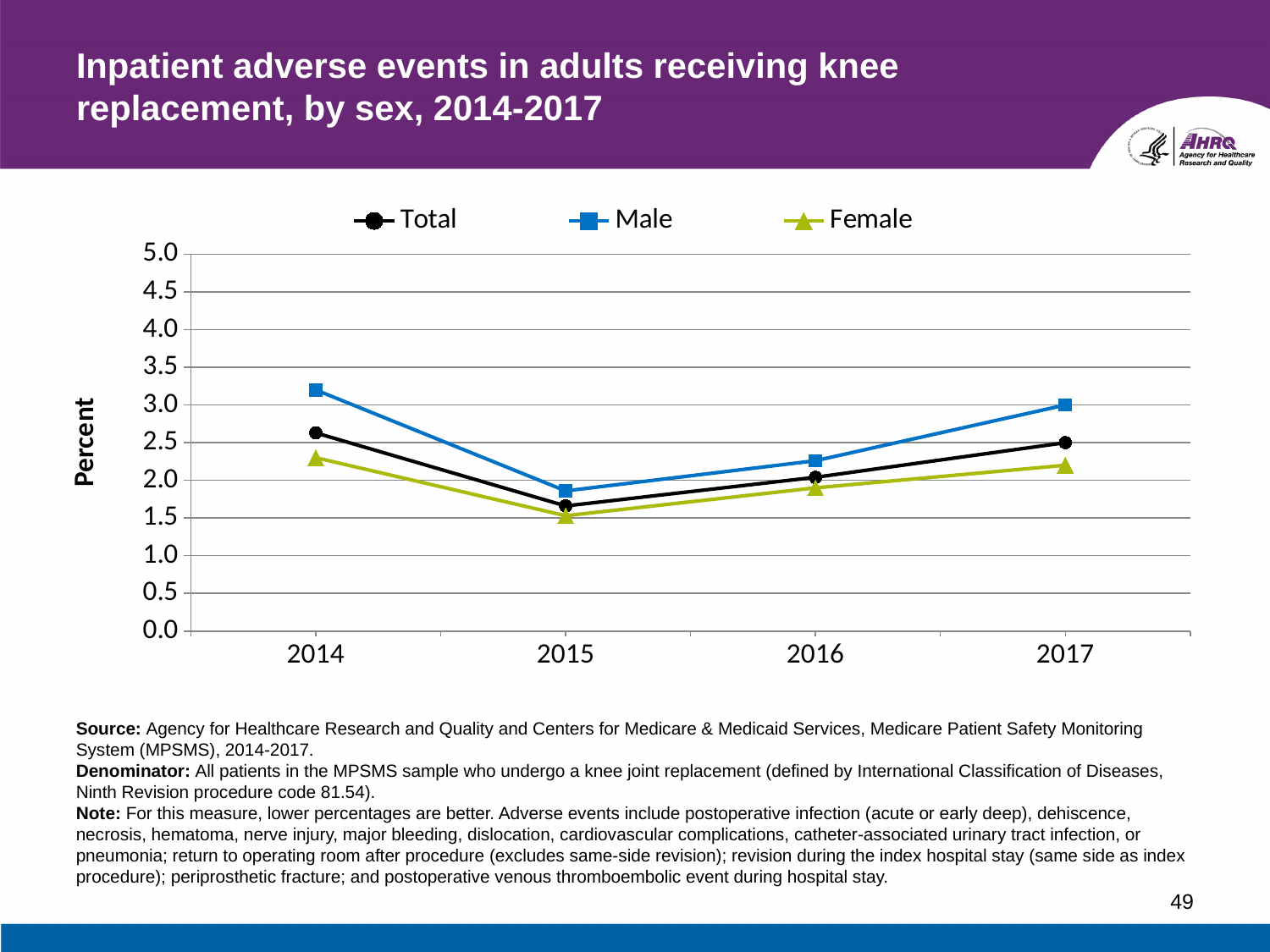
Is the Female value for 2015 greater or less than 2.0? less How many series does the legend list? 3 In which year is the Male value highest? 2014 What is the label on the y axis? Percent How many years are plotted on the x axis? 4 In which year is the Female value lowest? 2015 Does the Total line rise or fall from 2015 to 2017? rise In 2014, which is larger, the Male value or the Female value? Male What kind of chart is shown on the slide? line chart Is the Total value for 2017 greater or less than 2.0? greater Is the Male value for 2014 greater or less than 3.0? greater Does the Male line rise or fall from 2014 to 2015? fall